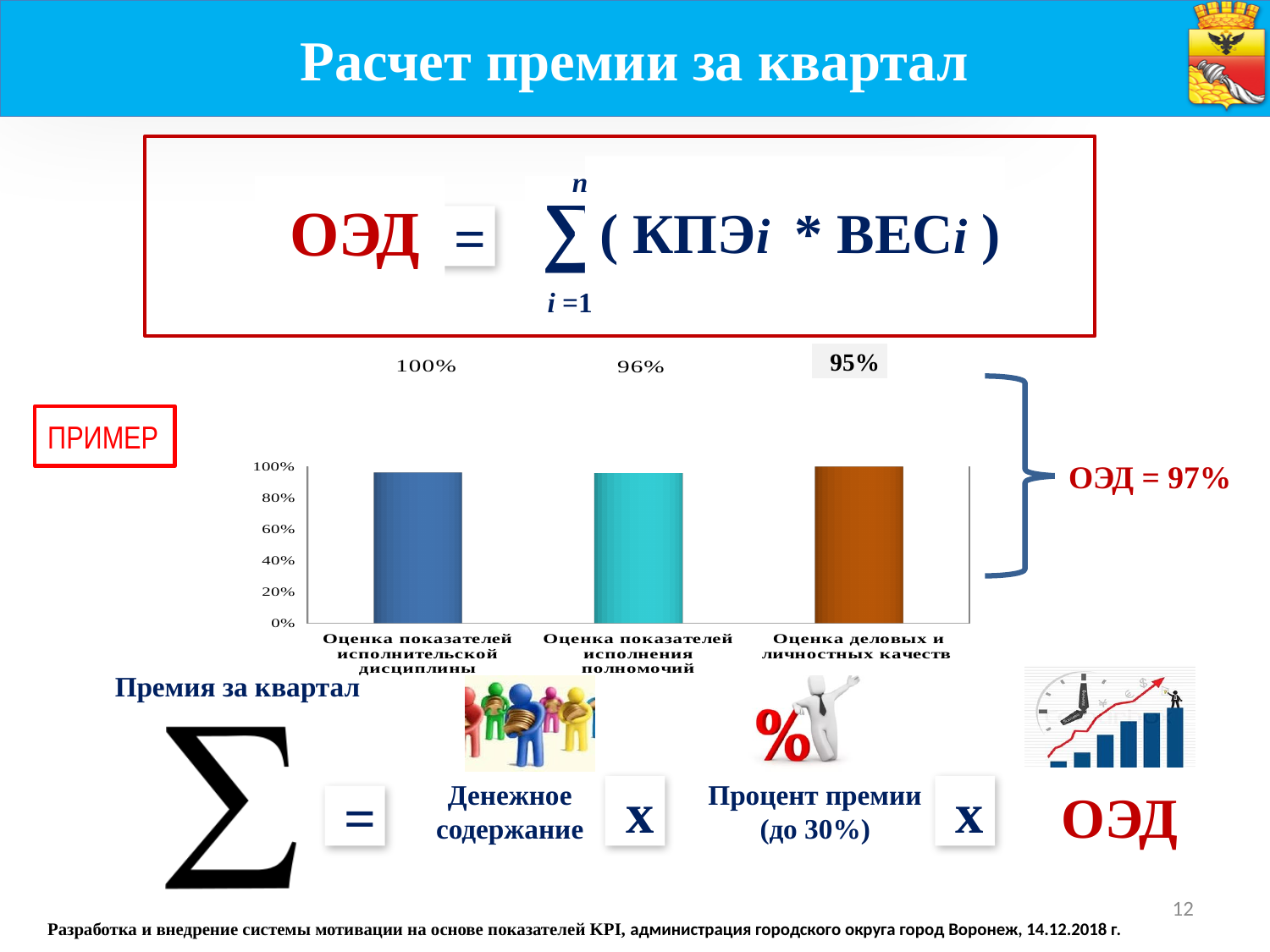
Are all three bars in the chart above the 80% line? yes What kind of chart is shown on the slide? bar chart What is the label of the first (leftmost) category on the x axis? Оценка показателей исполнительской дисциплины Is the value for "Оценка деловых и личностных качеств" greater or less than 80%? greater What is the highest tick value shown on the y axis of the chart? 100% What is the label of the third (rightmost) category on the x axis? Оценка деловых и личностных качеств What ОЭД value is shown next to the bracket to the right of the chart? ОЭД = 97% How many bars does the chart show? 3 Is the value for "Оценка показателей исполнительской дисциплины" greater or less than 80%? greater